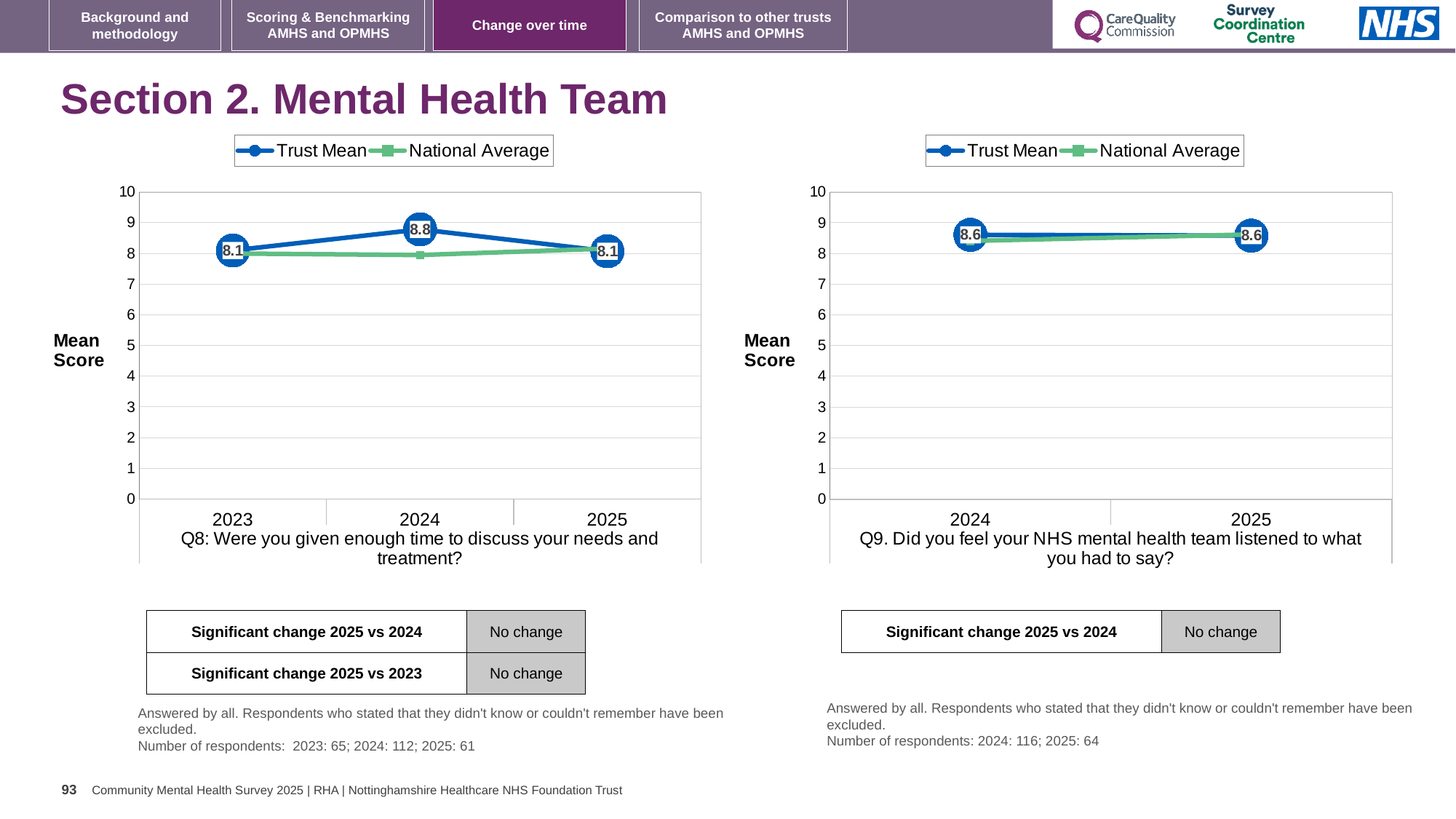
How many series does the legend of the Q9 chart (right) list? 2 What kind of chart is the Q8 chart (left)? Line chart On the Q8 chart (left), does the Trust Mean rise or fall from 2024 to 2025? Fall On the Q8 chart (left), how many years are shown on the x axis? 3 On the Q8 chart (left), what is the Trust Mean for 2023? 8.1 On the Q8 chart (left), which year has the highest Trust Mean? 2024 On the Q9 chart (right), how many years are shown on the x axis? 2 On the Q8 chart (left), what is the difference between the Trust Mean in 2024 and in 2025? 0.7 On the Q8 chart (left), is the Trust Mean for 2024 greater or less than 8? greater On the Q9 chart (right), what is the Trust Mean for 2025? 8.6 On the Q9 chart (right), is the National Average for 2024 greater or less than 8? greater On the Q8 chart (left), what is the Trust Mean for 2024? 8.8